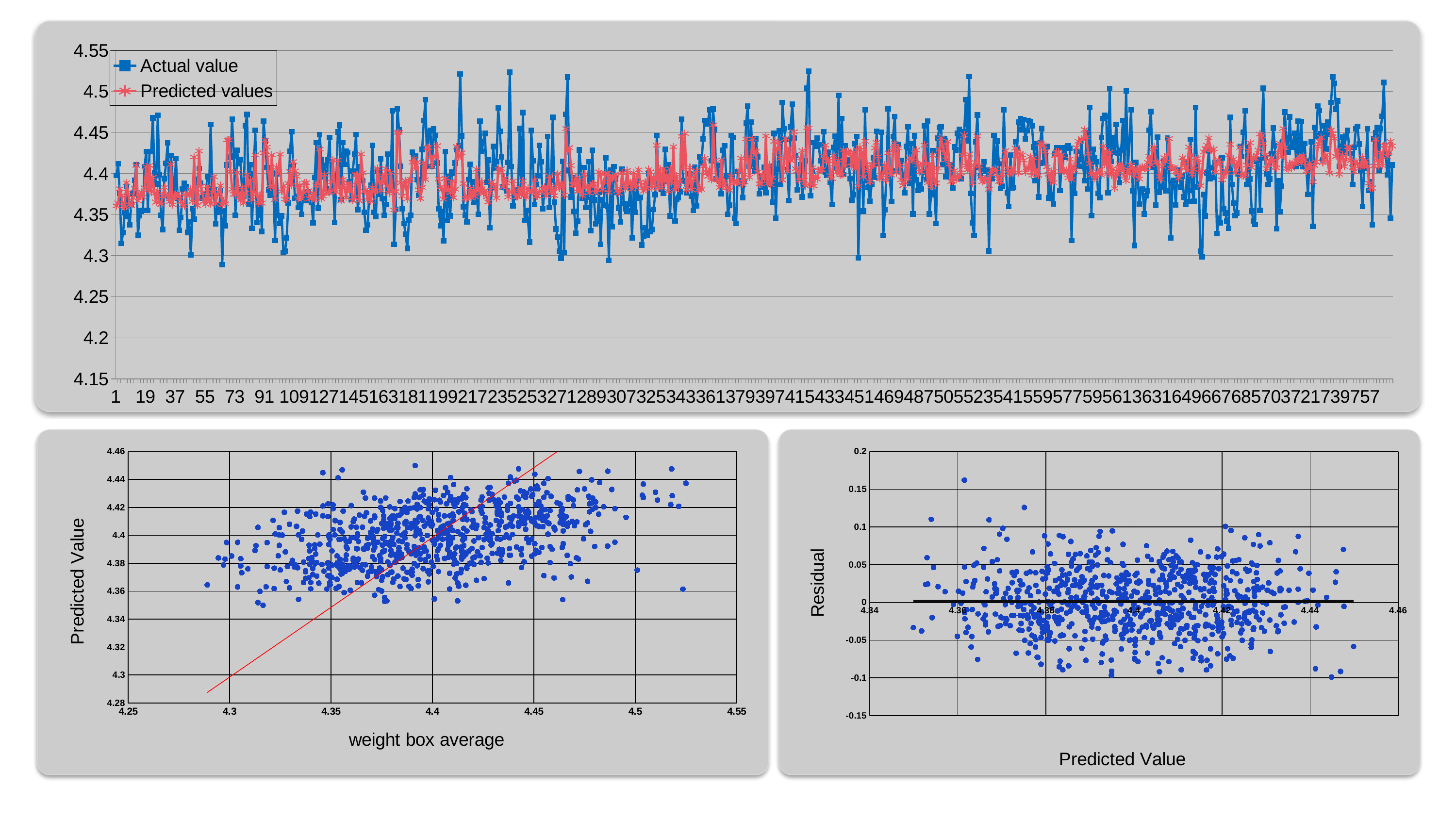
In the top chart, is the lowest Actual value greater or less than 4.25? greater In the top chart, is the highest Predicted value greater or less than 4.5? less What is the x-axis label of the bottom-left chart? weight box average In the bottom-right chart, is the largest Residual greater or less than 0.15? greater In the top chart, do the Predicted values generally rise or fall from left to right along the x axis? rise What kind of chart is the bottom-left chart on the slide? scatter chart What are the two series named in the legend of the top chart? Actual value, Predicted values How many series does the legend of the top chart list? 2 What kind of chart is the top chart on the slide? line chart